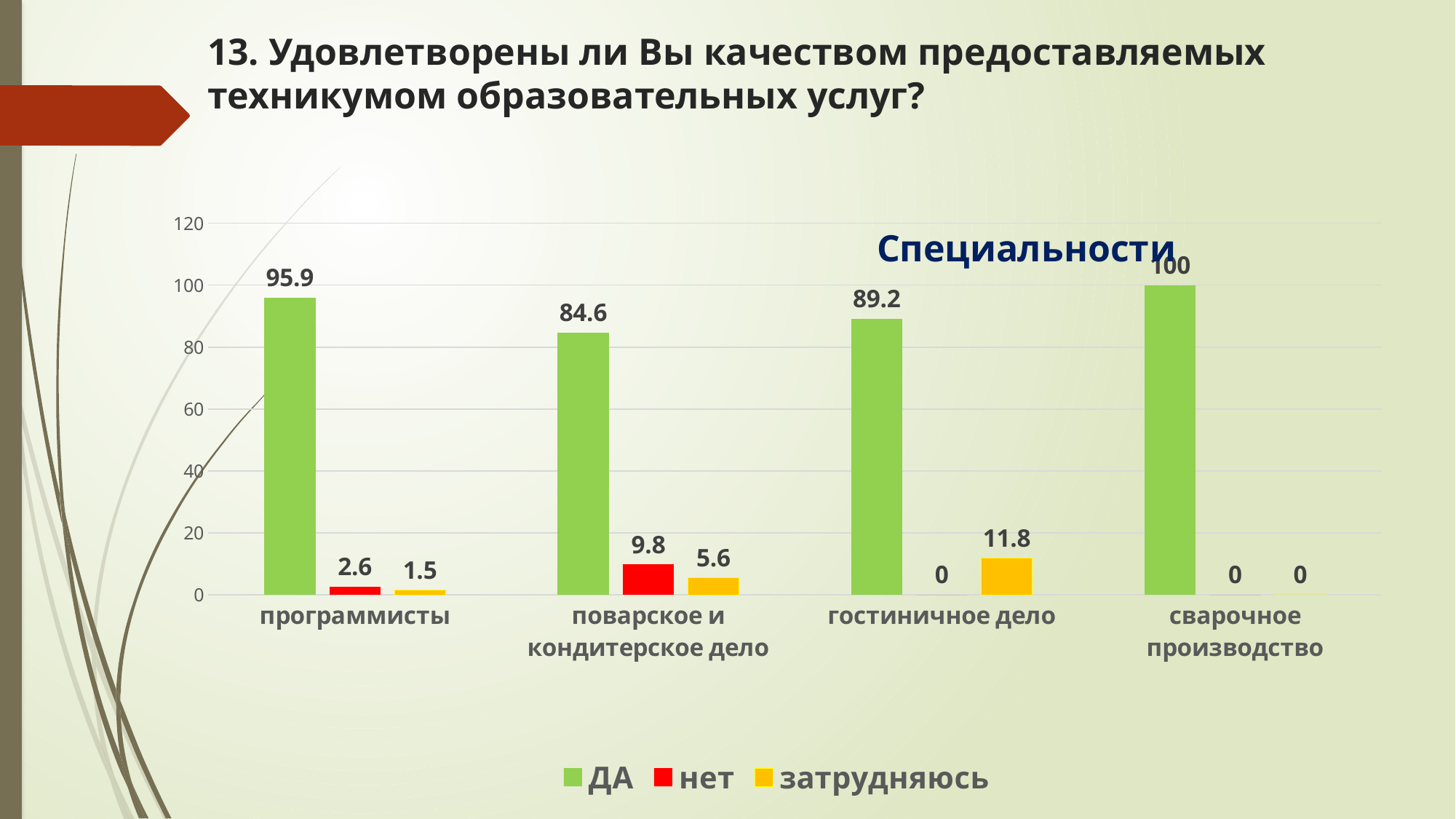
What is the value of ДА for программисты? 95.9 What is the value of нет for поварское и кондитерское дело? 9.8 What is the difference between the ДА values for программисты and гостиничное дело? 6.7 What kind of chart is shown on the slide? bar chart What is the value of ДА for сварочное производство? 100 How many categories are shown on the x axis? 4 Which category has the highest ДА value? сварочное производство How many series does the legend list? 3 Which category has the lowest ДА value? поварское и кондитерское дело What is the value of затрудняюсь for гостиничное дело? 11.8 Which is larger: the затрудняюсь value for поварское и кондитерское дело or for гостиничное дело? гостиничное дело Which colour represents the нет series? red